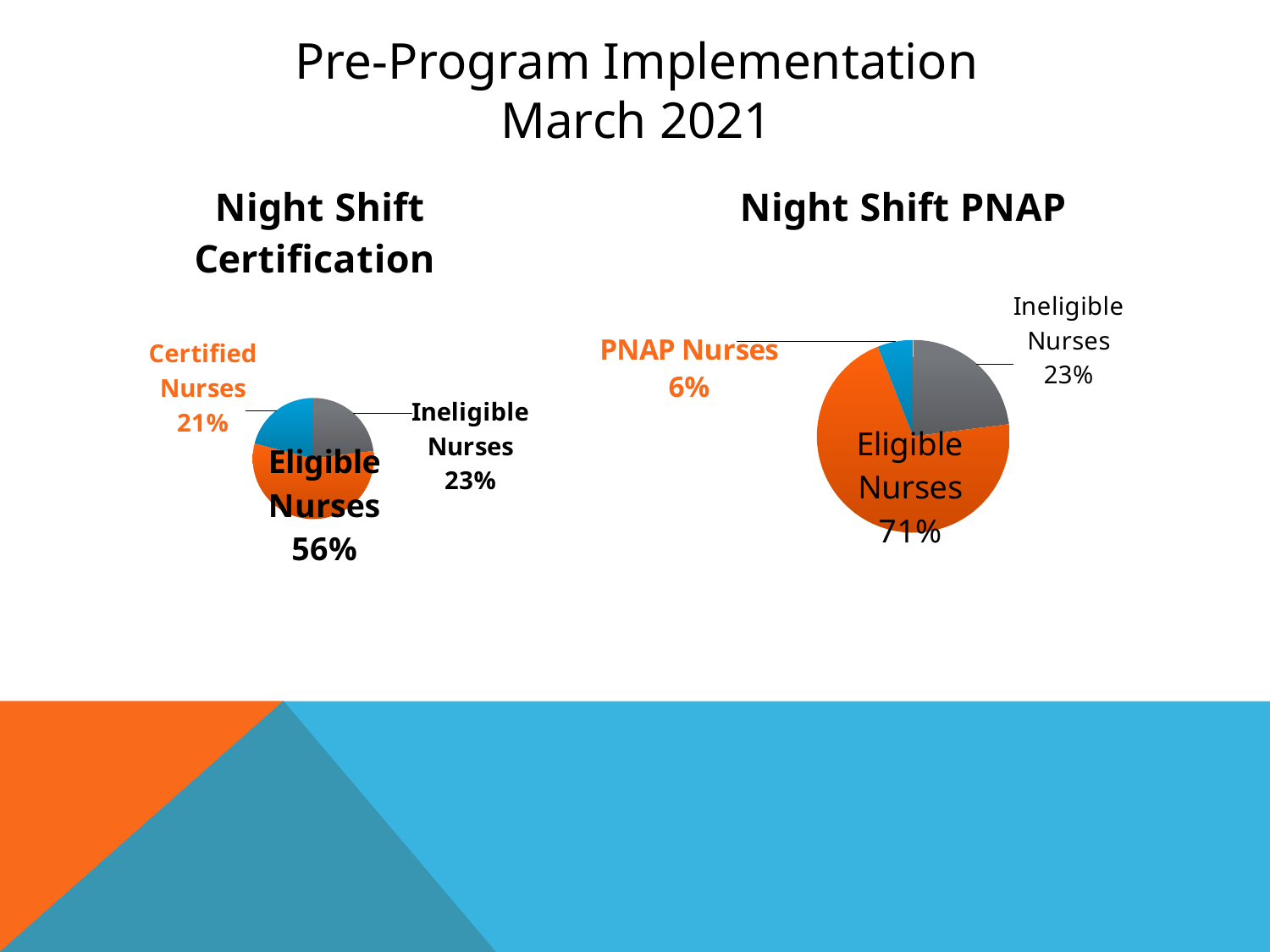
In the Night Shift PNAP chart, what percentage is shown for PNAP Nurses? 6% In the Night Shift Certification chart, which category has the largest share? Eligible Nurses In the Night Shift PNAP chart, what percentage is shown for Eligible Nurses? 71% In the Night Shift Certification chart, what percentage is shown for Certified Nurses? 21% In the Night Shift Certification chart, what percentage is shown for Eligible Nurses? 56% Which is larger: the Certified Nurses share in the Night Shift Certification chart or the PNAP Nurses share in the Night Shift PNAP chart? Certified Nurses In the Night Shift PNAP chart, which category has the smallest share? PNAP Nurses In the Night Shift PNAP chart, what percentage is shown for Ineligible Nurses? 23% How many slices does the Night Shift PNAP pie chart have? 3 In the Night Shift Certification chart, what is the difference in percentage points between Eligible Nurses and Certified Nurses? 35 In the Night Shift PNAP chart, what is the difference in percentage points between Eligible Nurses and Ineligible Nurses? 48 What type of chart is the Night Shift Certification chart? Pie chart